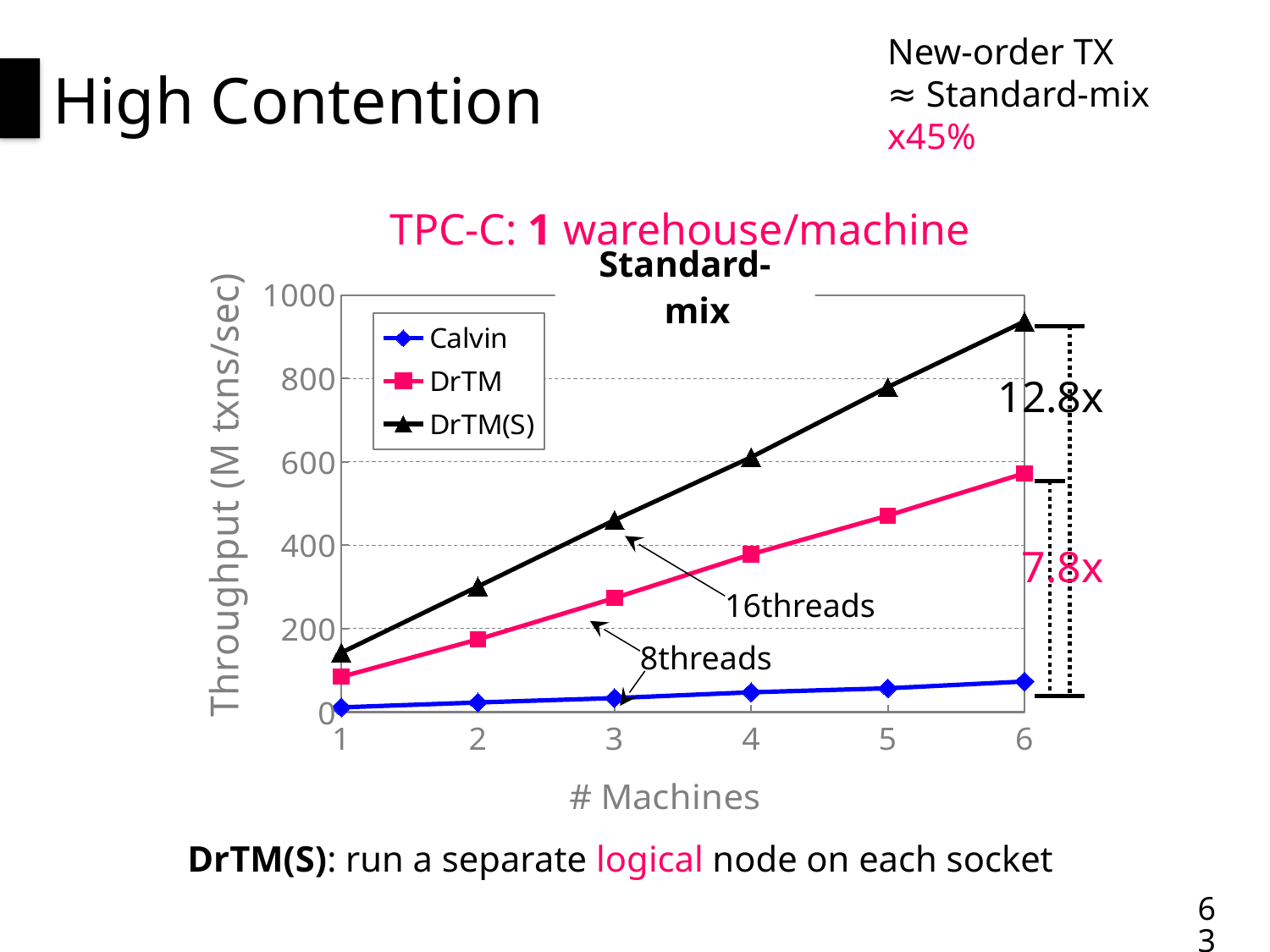
Which series has the highest throughput at 6 machines? DrTM(S) Which series has the lowest throughput at 6 machines? Calvin Does the throughput of DrTM(S) rise or fall as the number of machines increases? rise What is the label of the x axis? # Machines Is the throughput of Calvin at 6 machines greater or less than 200? less What kind of chart is shown on the slide? line chart Which is larger at 3 machines, the throughput of DrTM or of Calvin? DrTM Is the throughput of DrTM(S) at 6 machines greater or less than 800? greater What is the label of the y axis? Throughput (M txns/sec) Is the throughput of DrTM at 6 machines greater or less than 400? greater How many machine counts are plotted along the x axis? 6 How many series does the legend list? 3